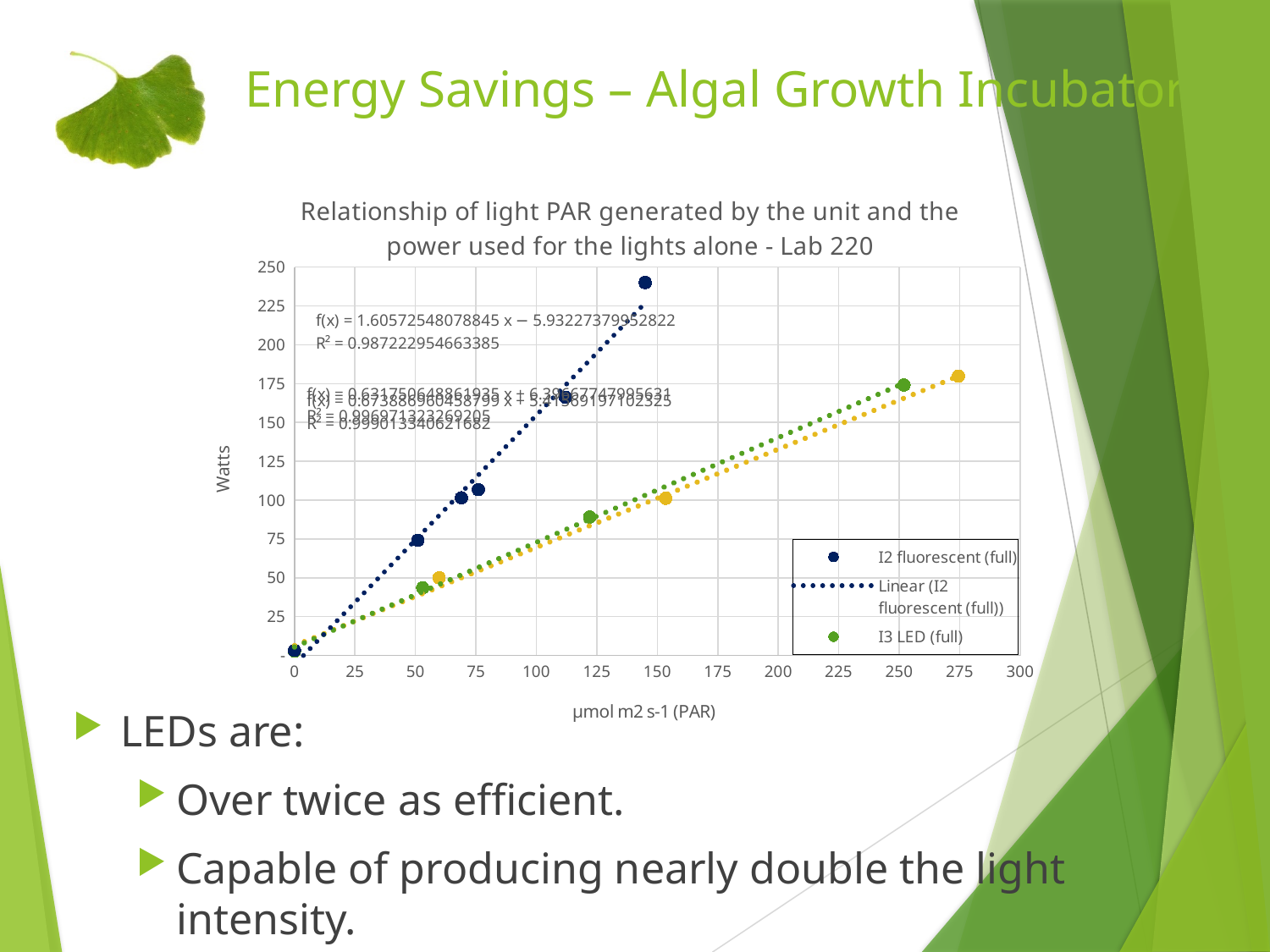
Is the I3 LED (full) point at about 250 PAR greater or less than 200 Watts? less Is the I3 LED (full) point at about 125 PAR greater or less than 100 Watts? less At about 50 PAR, which series uses more Watts, I2 fluorescent (full) or I3 LED (full)? I2 fluorescent (full) Do the Watts values for the I2 fluorescent (full) series rise or fall as PAR increases along the x axis? Rise What R² value is shown for the I2 fluorescent (full) trendline (the top equation)? 0.987222954663385 Is the I3 LED (full) point at about 250 PAR greater or less than 150 Watts? greater What is the label of the y axis of the chart? Watts Which series has the steeper trendline, I2 fluorescent (full) or I3 LED (full)? I2 fluorescent (full) Which series reaches the highest Watts value on the chart? I2 fluorescent (full) What kind of chart is shown on the slide? Scatter chart